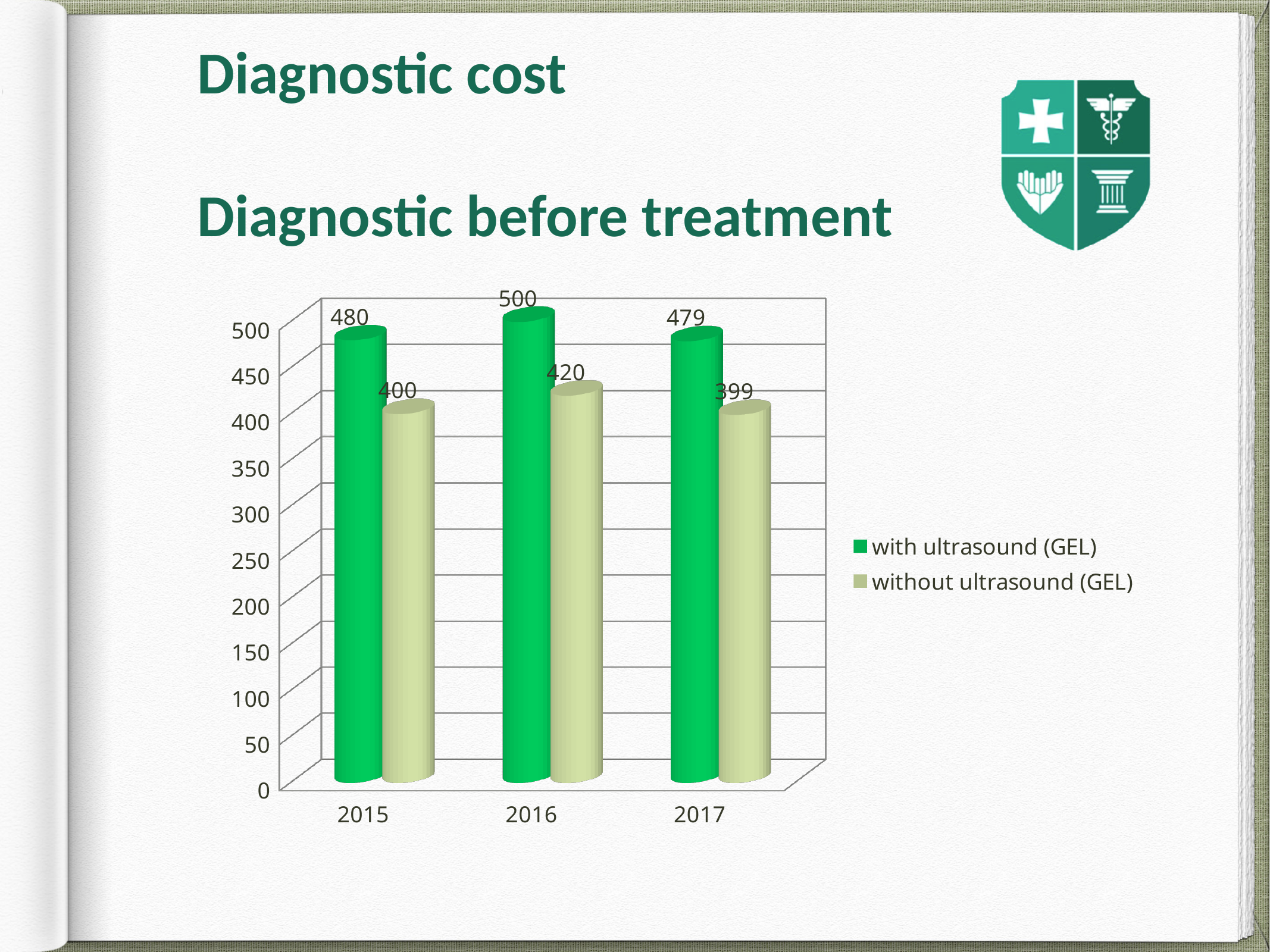
How many series does the legend list? 2 What is the difference between the 'with ultrasound (GEL)' values in 2016 and 2017? 21 What is the difference between the 'with ultrasound (GEL)' and 'without ultrasound (GEL)' values in 2015? 80 What kind of chart is shown on the slide? bar chart Which is larger in 2016: the 'with ultrasound (GEL)' value or the 'without ultrasound (GEL)' value? with ultrasound (GEL) What is the value for 'with ultrasound (GEL)' in 2016? 500 What is the value for 'without ultrasound (GEL)' in 2017? 399 In which year is the 'without ultrasound (GEL)' value lowest? 2017 How many years are shown on the x axis of the chart? 3 In which year is the 'with ultrasound (GEL)' value highest? 2016 Which colour represents the 'without ultrasound (GEL)' series in the legend? light green What is the value for 'with ultrasound (GEL)' in 2015? 480